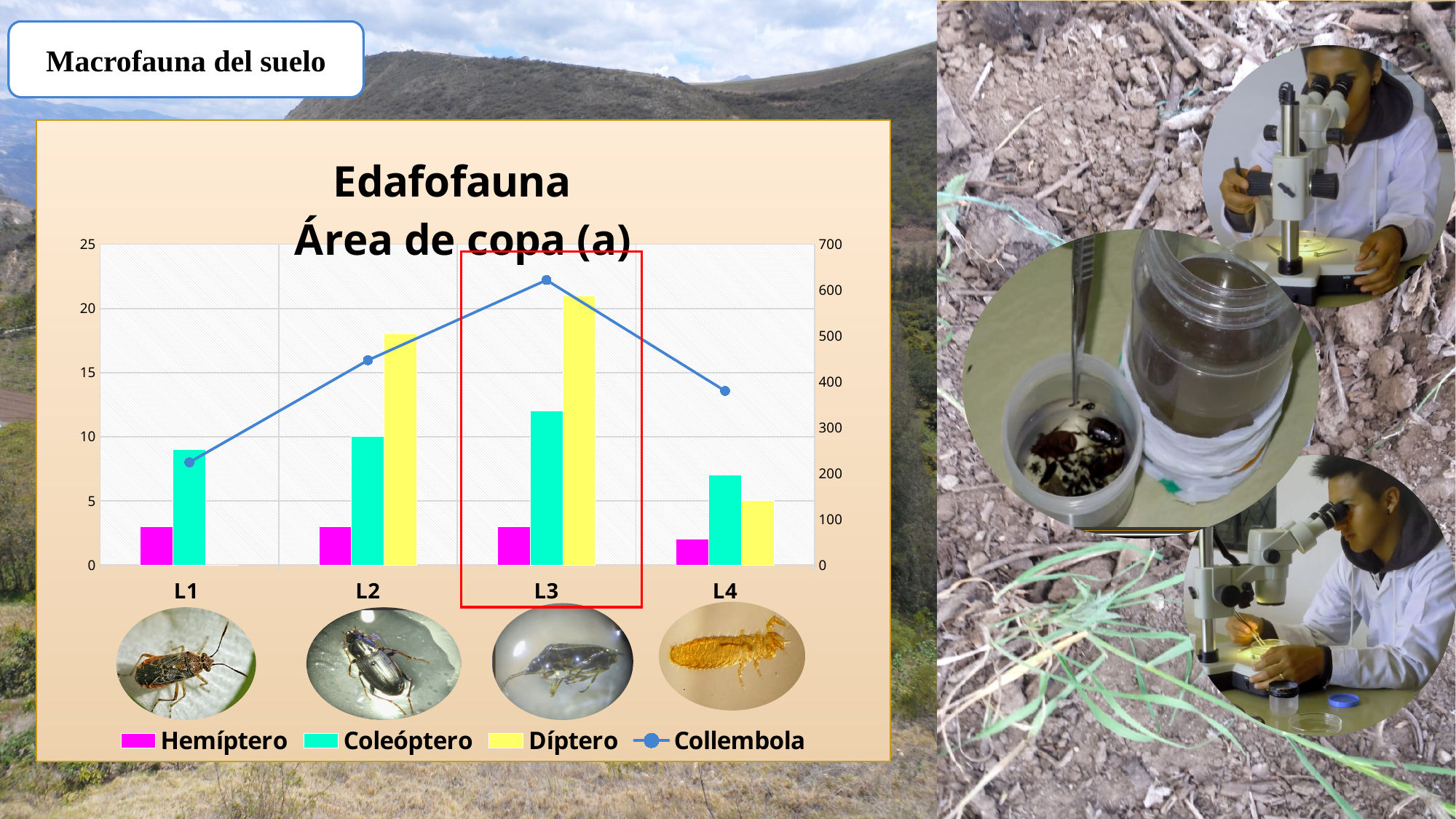
What kind of chart is shown on the slide? A combined bar and line chart How many categories are shown on the x axis of the Edafofauna chart? 4 Is the Collembola value for L3 greater or less than 600? greater In which category does the Collembola line reach its highest point? L3 Which category on the chart is outlined with a red box? L3 Is the Díptero value for L3 greater or less than 20? greater Which has the larger Díptero value, L2 or L4? L2 Is the Collembola value for L1 greater or less than 300? less In which category is the Díptero bar highest? L3 In which category is the Coleóptero bar lowest? L4 How does the Collembola line change from L1 to L4? It rises from L1 to L3, then falls at L4 How many series does the legend of the Edafofauna chart list? 4